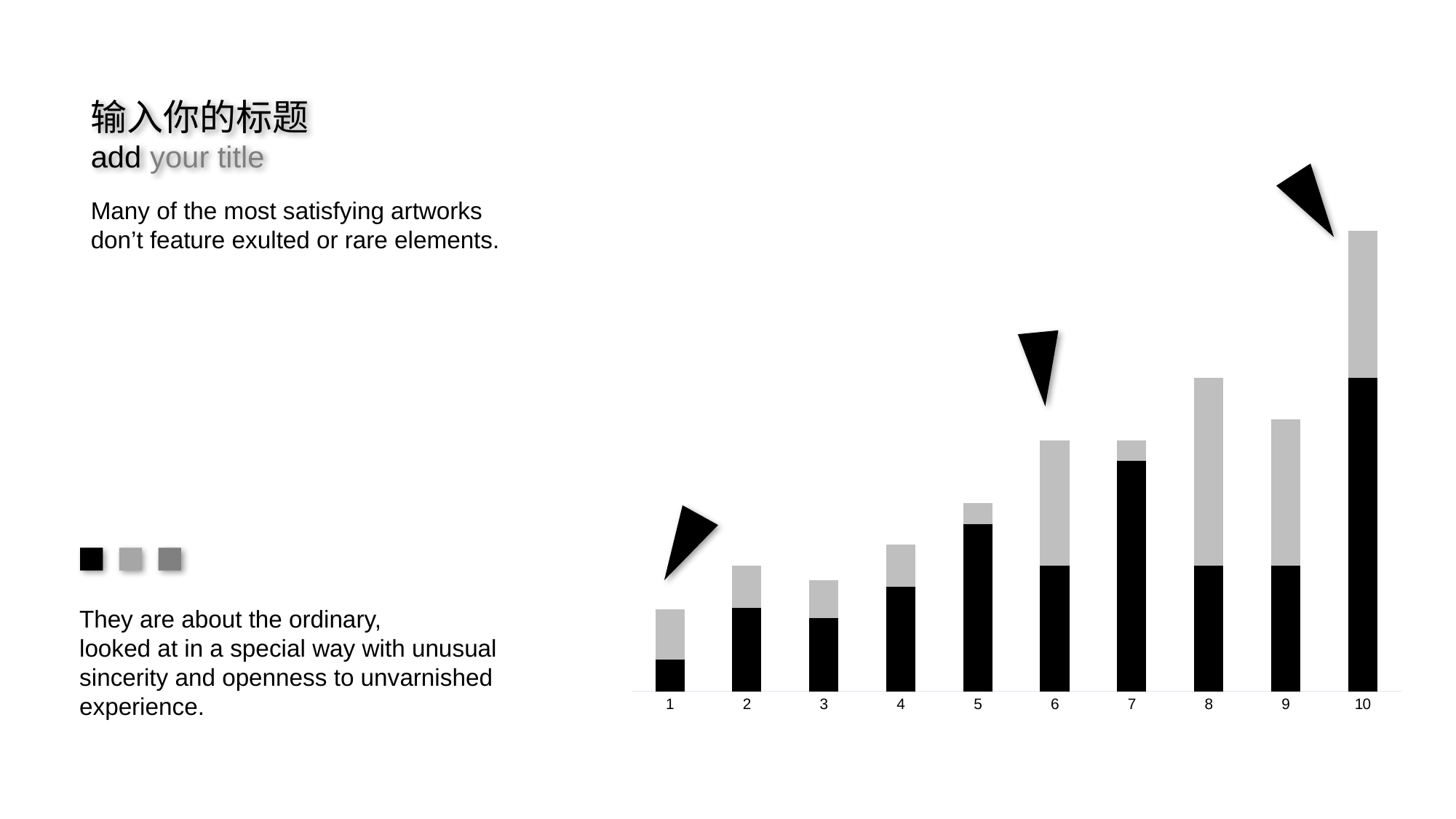
Which category has the largest grey segment? 8 Is the total bar for category 2 taller or shorter than the total bar for category 3? taller What kind of chart is shown on the slide? stacked bar chart Which category has the tallest stacked bar overall? 10 Do the bar heights generally rise or fall from category 1 to category 10? rise Which category has the shortest black segment? 1 Is the total bar for category 8 taller or shorter than the total bar for category 9? taller What two colours are used for the segments of the stacked bars? black and grey Which category has the shortest stacked bar overall? 1 How many series are stacked in each bar of the chart? 2 Which category has the tallest black segment? 10 How many categories are shown along the x axis of the chart? 10